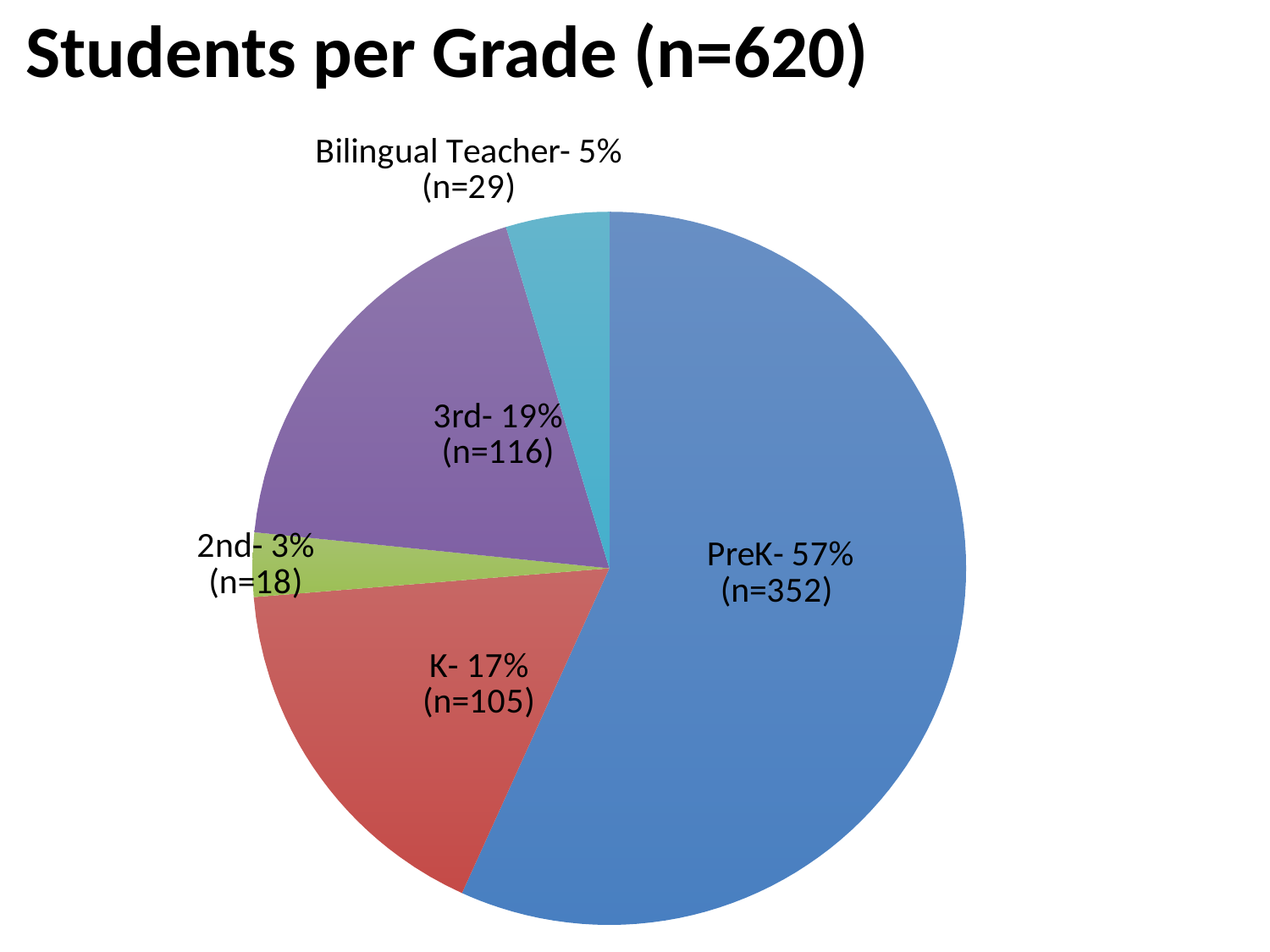
How many students are in 3rd grade? 116 How many more students are in 3rd grade than in K? 11 Which category has the smallest number of students? 2nd How many students are in the Bilingual Teacher category? 29 What is the title of the chart? Students per Grade (n=620) What is the difference in student count between PreK and 3rd grade? 236 What share of the pie does the Bilingual Teacher slice represent? 5% How many slices does the pie chart have? 5 What kind of chart is shown on the slide? pie chart Which grade has the largest number of students? PreK Which has more students, K or 2nd? K What percentage of students are in PreK? 57%